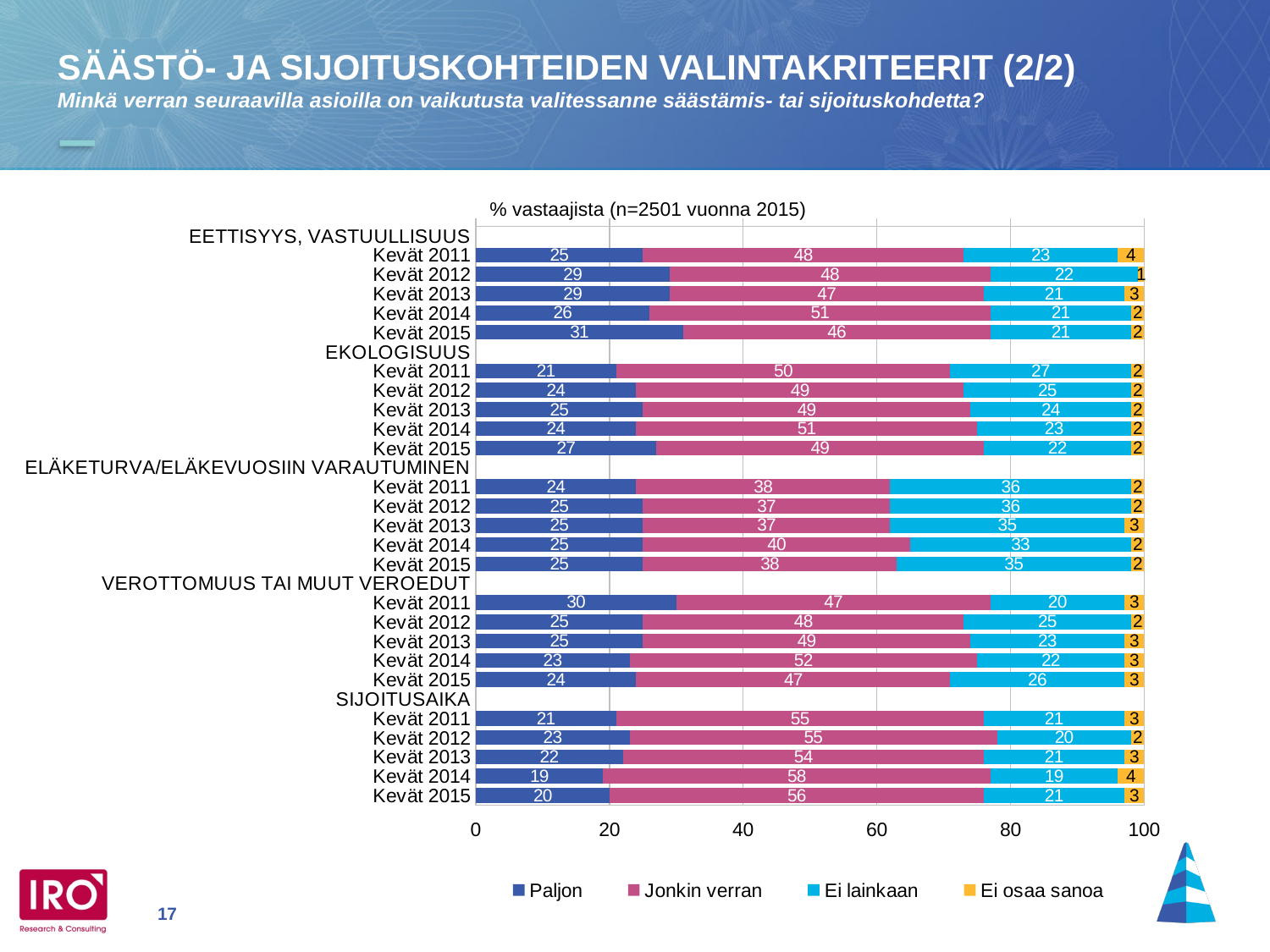
What is the total of the stacked bar for Kevät 2014 under ELÄKETURVA/ELÄKEVUOSIIN VARAUTUMINEN? 100 What kind of chart is shown on the slide? stacked bar chart What is the Ei osaa sanoa value for Kevät 2012 under EETTISYYS, VASTUULLISUUS? 1 Which bar has the highest Jonkin verran value? Kevät 2014 under SIJOITUSAIKA How many series does the legend list? 4 What is the chart's title shown above the plot area? % vastaajista (n=2501 vuonna 2015) What is the difference between the Paljon values for Kevät 2011 and Kevät 2015 under VEROTTOMUUS TAI MUUT VEROEDUT? 6 What is the Paljon value for Kevät 2015 under EETTISYYS, VASTUULLISUUS? 31 What is the Jonkin verran value for Kevät 2014 under SIJOITUSAIKA? 58 Which bar has the lowest Paljon value? Kevät 2014 under SIJOITUSAIKA Which is larger: the Ei lainkaan value for Kevät 2011 under EKOLOGISUUS or for Kevät 2011 under EETTISYYS, VASTUULLISUUS? Kevät 2011 under EKOLOGISUUS What is the Ei lainkaan value for Kevät 2011 under ELÄKETURVA/ELÄKEVUOSIIN VARAUTUMINEN? 36